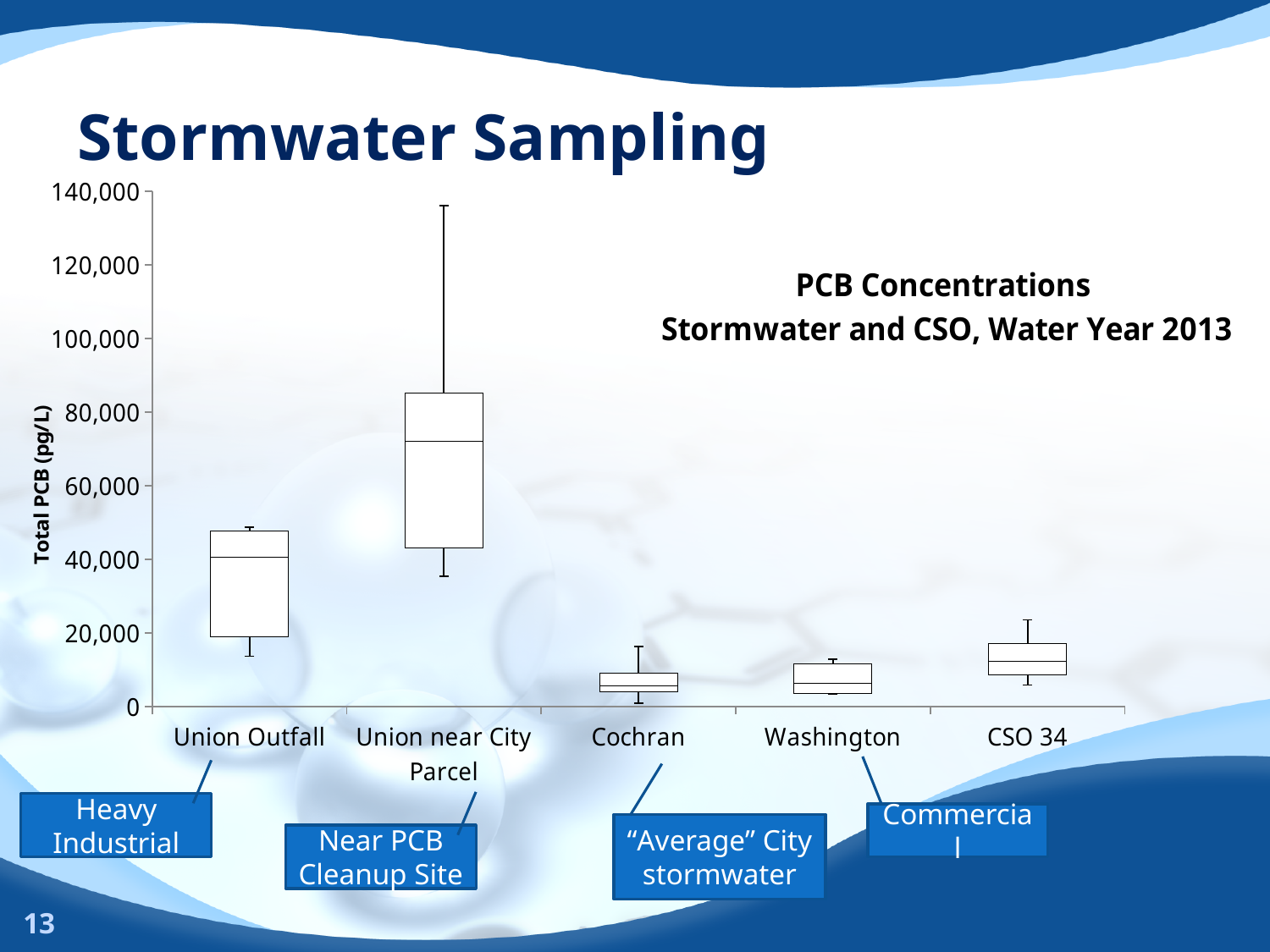
How many sampling sites (categories) are shown on the x axis? 5 Is the top whisker for Union Outfall greater or less than 60,000? less Is the median value for Union near City Parcel greater or less than 60,000? greater Which site has the highest median PCB concentration? Union near City Parcel What is the title of the chart? PCB Concentrations Stormwater and CSO, Water Year 2013 Which has the larger median PCB concentration, Union Outfall or Union near City Parcel? Union near City Parcel Which has the larger median PCB concentration, Cochran or CSO 34? CSO 34 What kind of chart is shown on the slide? Box plot (box-and-whisker chart) Which site has the highest maximum (top whisker) PCB concentration? Union near City Parcel Is the top whisker for Union near City Parcel greater or less than 120,000? greater What is the label on the y axis of the chart? Total PCB (pg/L)